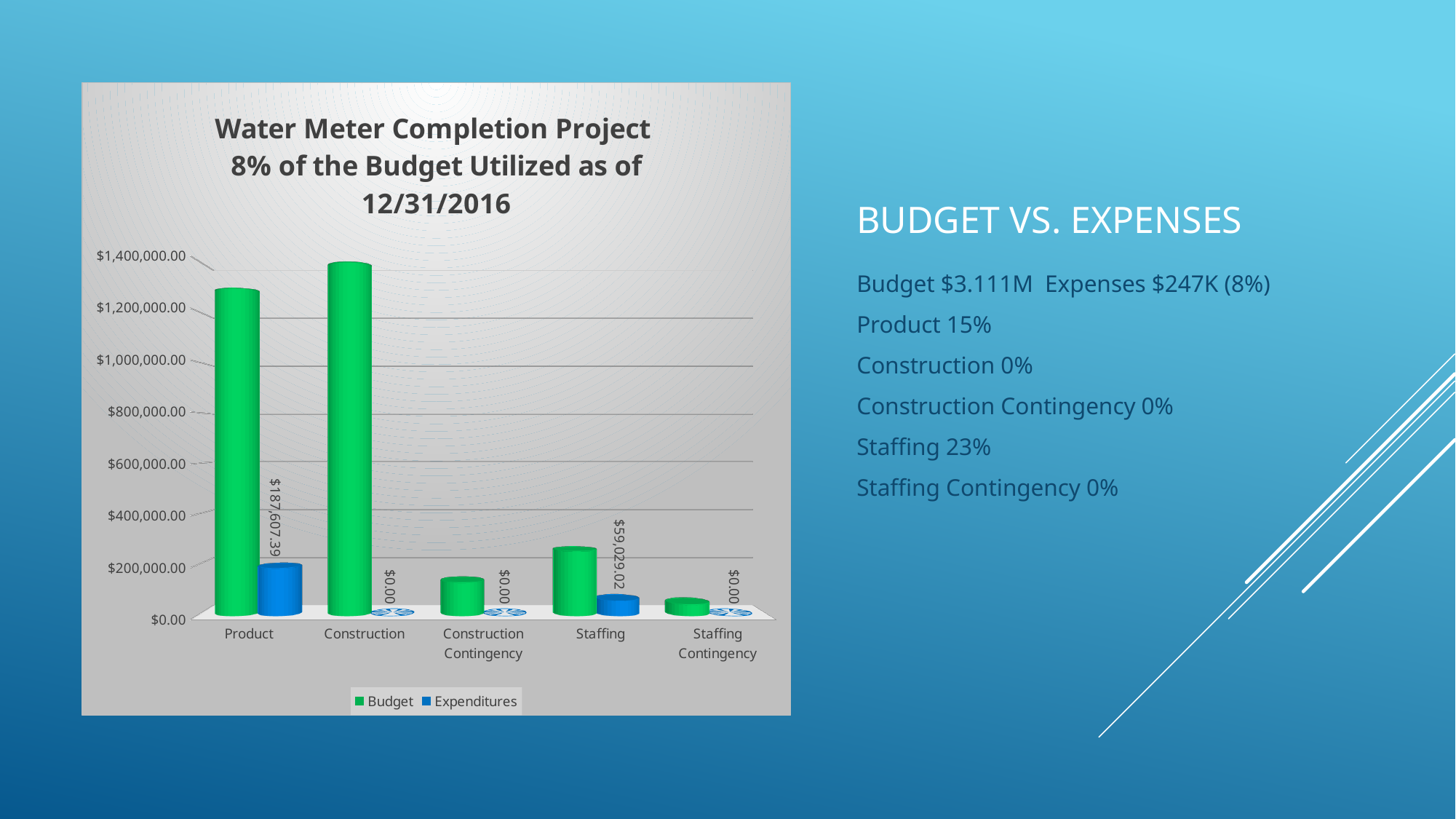
What is the Expenditures value for Staffing? $59,029.02 What is the Expenditures value for Construction Contingency? $0.00 How many categories are shown on the x axis? 5 What is the Expenditures value for Product? $187,607.39 What kind of chart is shown on the slide? Bar chart Is the Budget value for Product greater or less than $1,200,000.00? greater Is the Budget value for Staffing greater or less than $400,000.00? less What is the difference between the Expenditures for Product and the Expenditures for Staffing? $128,578.37 Which is larger, the Budget for Product or the Budget for Construction? Construction Which category has the lowest Budget? Staffing Contingency Which category has the highest Budget? Construction How many series does the legend list? 2